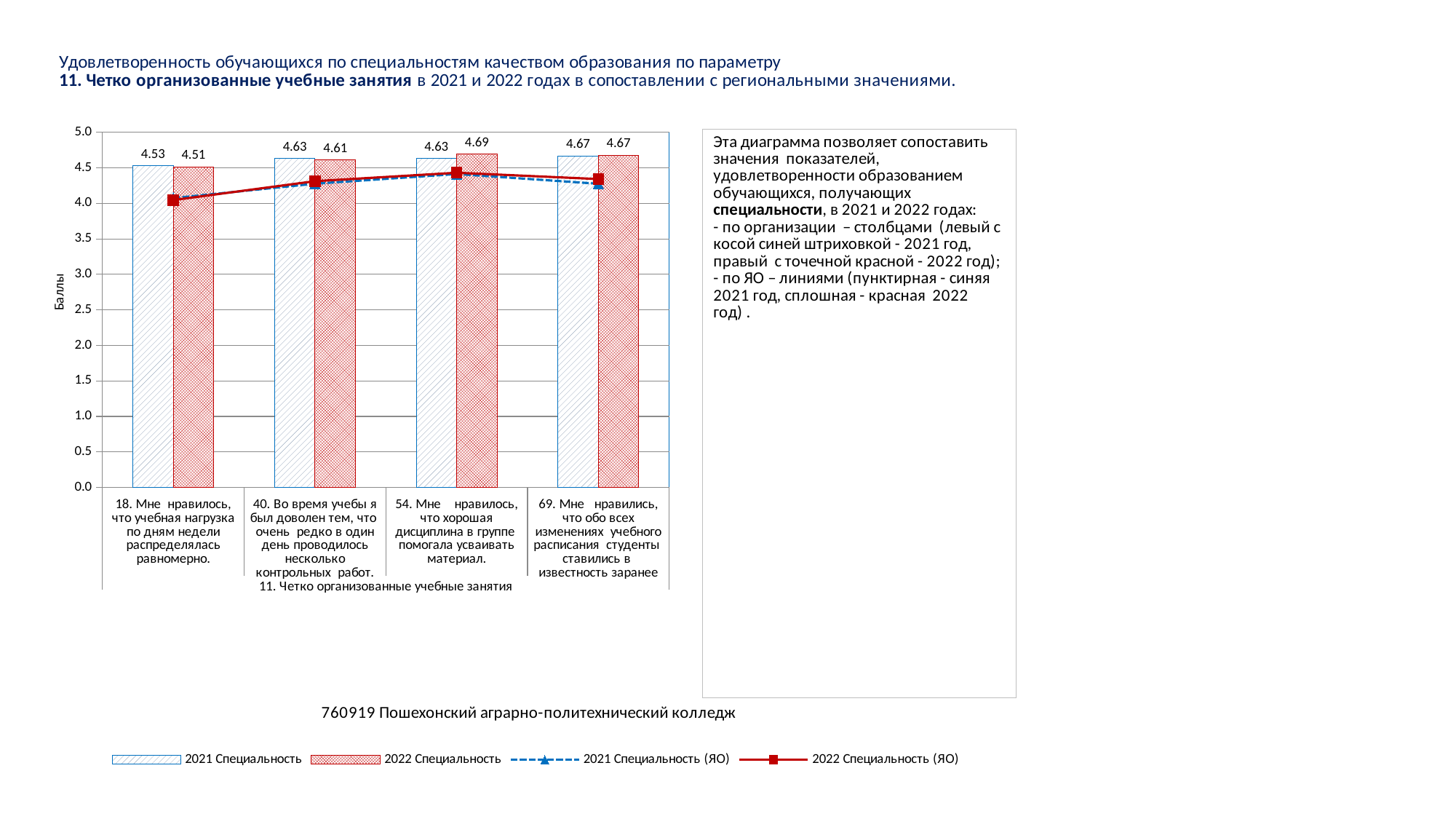
What is the difference between the 2022 and 2021 Специальность values for category 54? 0.06 How many categories are shown on the x axis? 4 What is the value of the 2022 Специальность bar for category 54 (Мне нравилось, что хорошая дисциплина в группе помогала усваивать материал)? 4.69 What is the value of the 2022 Специальность bar for category 40 (Во время учебы я был доволен тем, что очень редко в один день проводилось несколько контрольных работ)? 4.61 Which category has the highest 2022 Специальность bar? 54. Мне нравилось, что хорошая дисциплина в группе помогала усваивать материал. What kind of chart is shown on the slide? Combined bar and line chart How many series does the legend list? 4 Which category has the lowest 2021 Специальность bar? 18. Мне нравилось, что учебная нагрузка по дням недели распределялась равномерно. What is the value of the 2021 Специальность bar for category 18 (Мне нравилось, что учебная нагрузка по дням недели распределялась равномерно)? 4.53 Is the 2021 Специальность (ЯО) line value for category 18 greater or less than 4.5? less For category 40, which is larger: the 2021 Специальность bar or the 2022 Специальность bar? 2021 Специальность What is the label of the y axis? Баллы